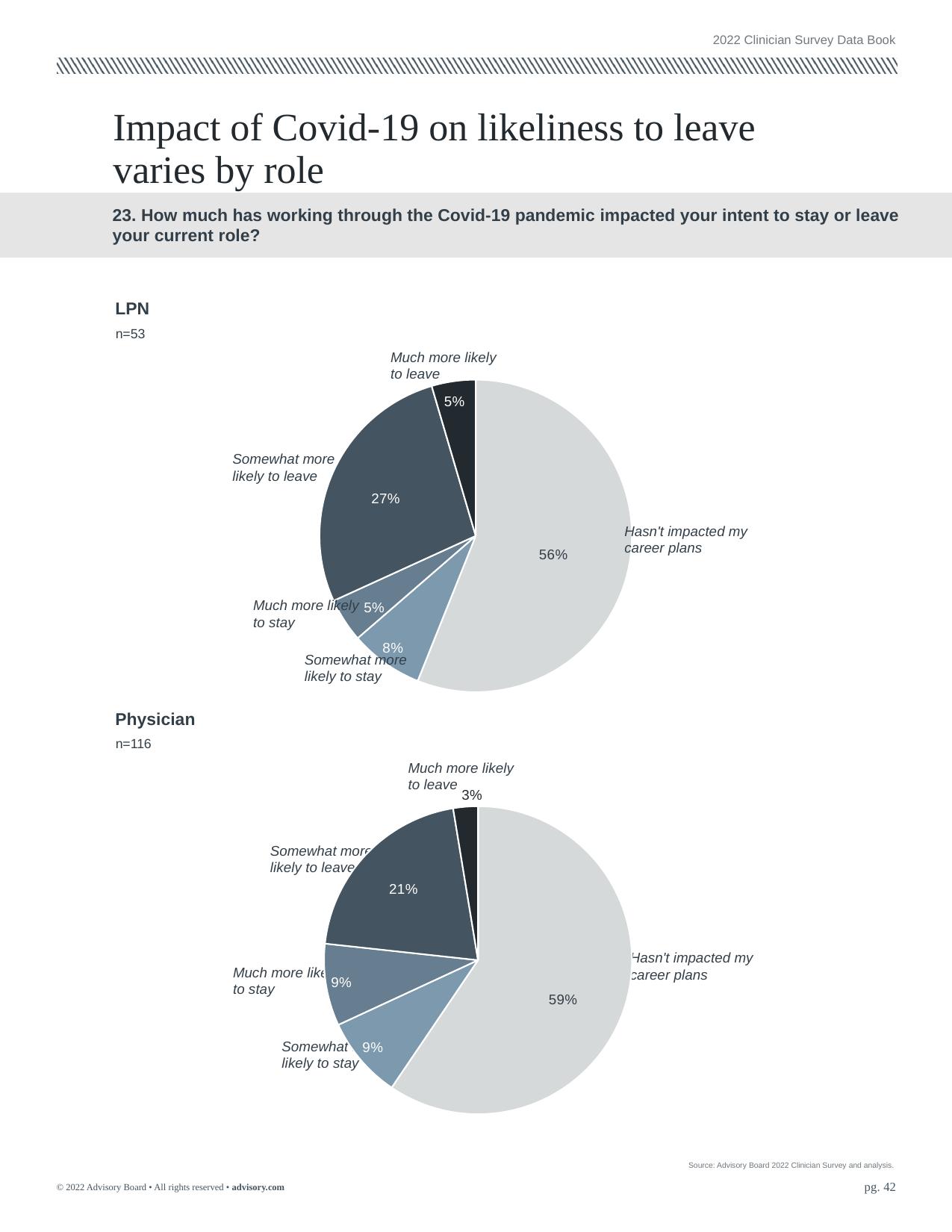
What type of chart is used for the Physician data? Pie chart What is the difference between the 'Somewhat more likely to leave' share in the LPN chart and in the Physician chart? 6 percentage points In the LPN pie chart, what share of respondents said Covid-19 hasn't impacted their career plans? 56% What is the sample size (n) shown for the Physician chart? n=116 How many categories are shown in the LPN pie chart? 5 In the LPN pie chart, which category has the largest slice? Hasn't impacted my career plans In the Physician pie chart, which category has the smallest slice? Much more likely to leave In the Physician pie chart, what share of respondents said they are much more likely to leave? 3% In the LPN pie chart, what share of respondents said they are somewhat more likely to stay? 8% Which chart shows a larger share for 'Hasn't impacted my career plans', LPN or Physician? Physician In the Physician pie chart, what share of respondents said they are somewhat more likely to leave? 21% In the Physician pie chart, what is the combined share of respondents who are much more or somewhat more likely to stay? 18%